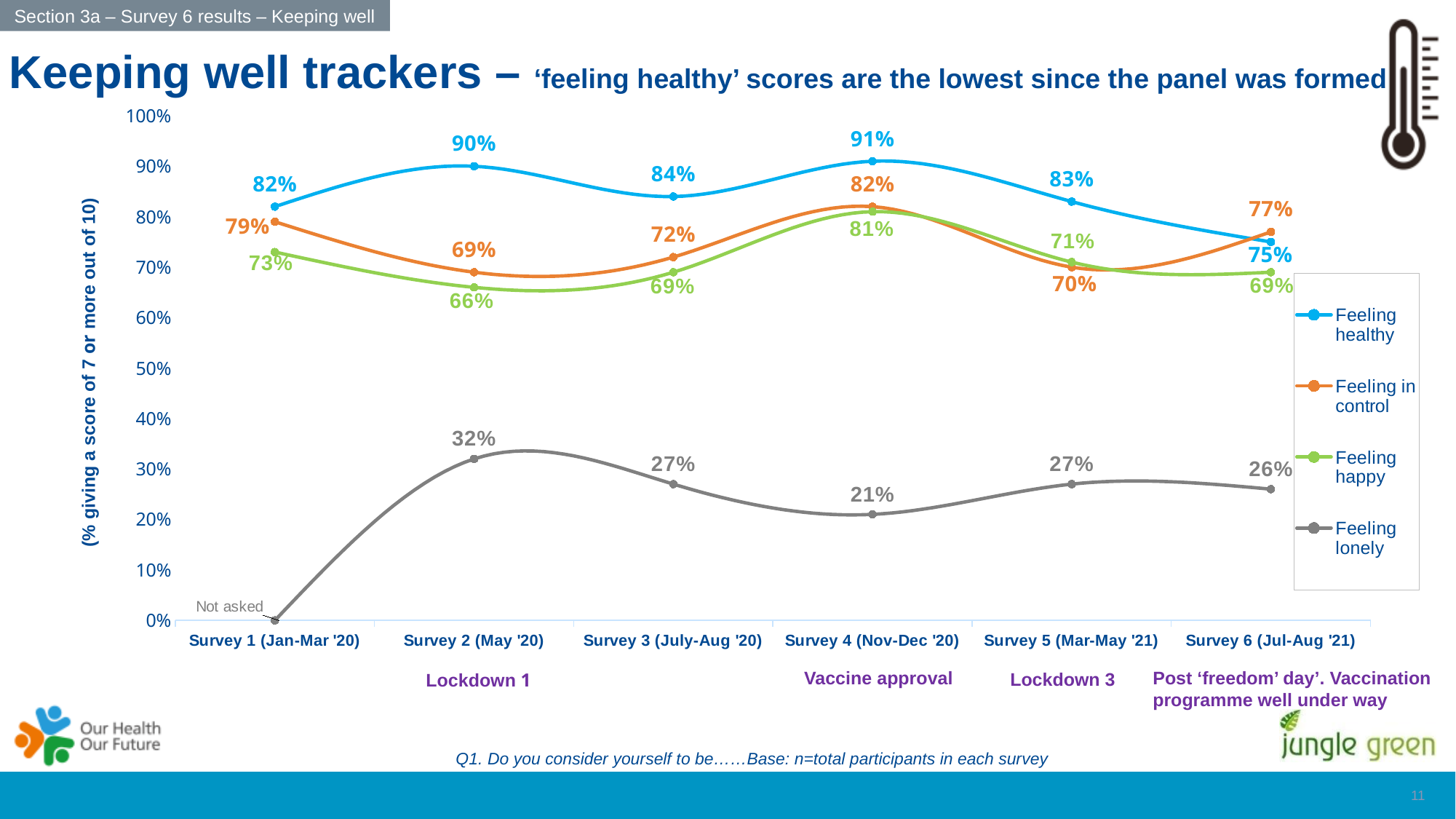
Which is larger at Survey 5 (Mar-May '21): 'Feeling happy' or 'Feeling in control'? Feeling happy In which survey is the 'Feeling happy' score highest? Survey 4 (Nov-Dec '20) How many series does the legend list? 4 What is the 'Feeling in control' value for Survey 6 (Jul-Aug '21)? 77% What label is shown for 'Feeling lonely' at Survey 1 (Jan-Mar '20)? Not asked Does the 'Feeling healthy' score rise or fall from Survey 4 (Nov-Dec '20) to Survey 6 (Jul-Aug '21)? Fall How many surveys are shown along the x axis? 6 In which survey is the 'Feeling healthy' score lowest? Survey 6 (Jul-Aug '21) What is the 'Feeling healthy' value for Survey 4 (Nov-Dec '20)? 91% What is the 'Feeling lonely' value for Survey 2 (May '20)? 32% What type of chart is shown on the slide? Line chart What is the difference between the 'Feeling healthy' values for Survey 4 (Nov-Dec '20) and Survey 6 (Jul-Aug '21)? 16%